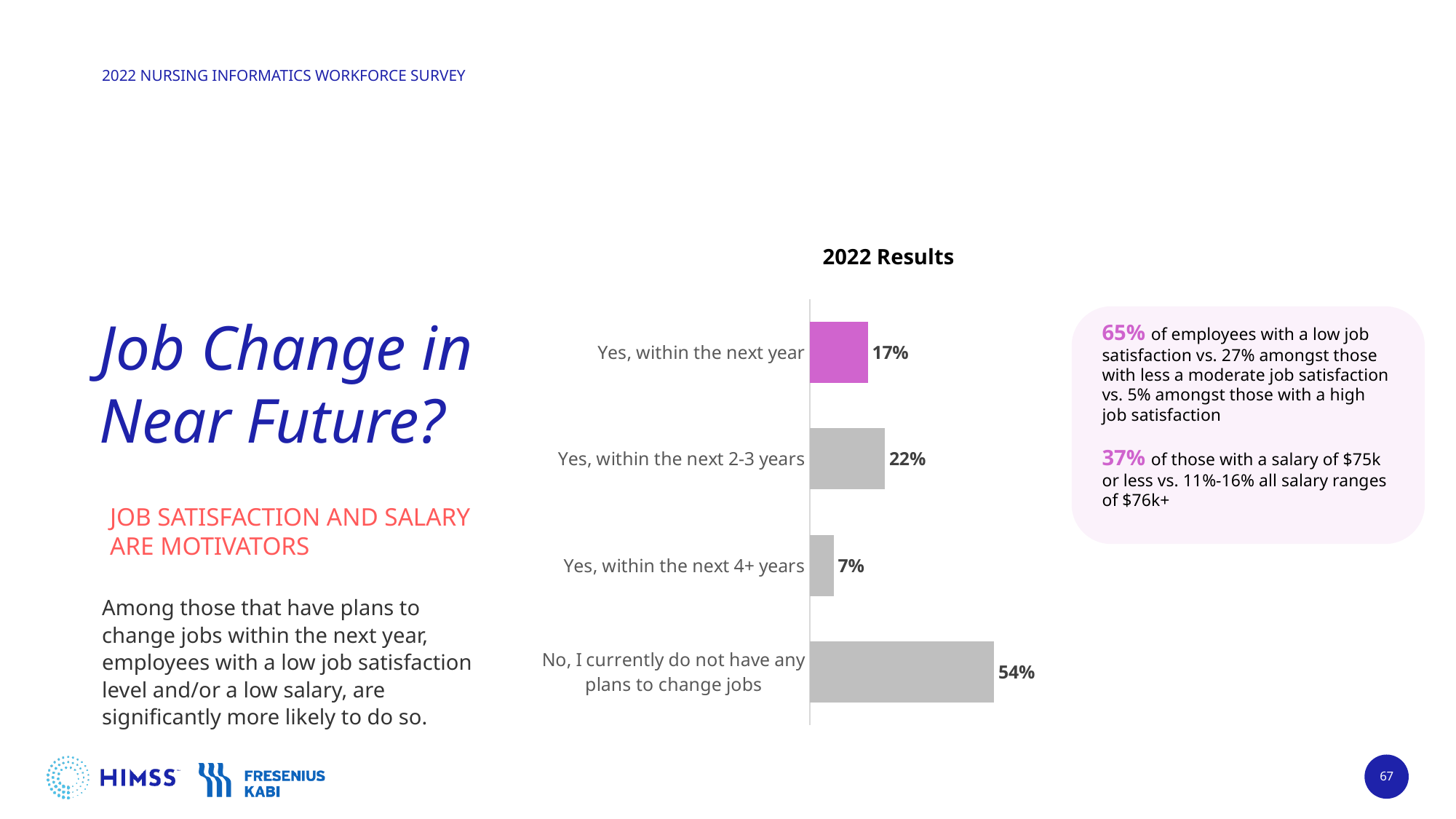
What percentage of respondents plan to change jobs within the next year? 17% What percentage of respondents currently do not have any plans to change jobs? 54% Which is larger: the value for "Yes, within the next year" or "Yes, within the next 4+ years"? Yes, within the next year Which category has the highest value in the chart? No, I currently do not have any plans to change jobs How many categories are shown in the chart? 4 What is the difference between the value for "No, I currently do not have any plans to change jobs" and "Yes, within the next 2-3 years"? 32% What is the title of the chart? 2022 Results What is the value for "Yes, within the next 4+ years"? 7% Which category has the lowest value in the chart? Yes, within the next 4+ years What is the value for "Yes, within the next 2-3 years"? 22% What is the difference between the value for "Yes, within the next 2-3 years" and "Yes, within the next year"? 5% What kind of chart is shown on the slide? Bar chart